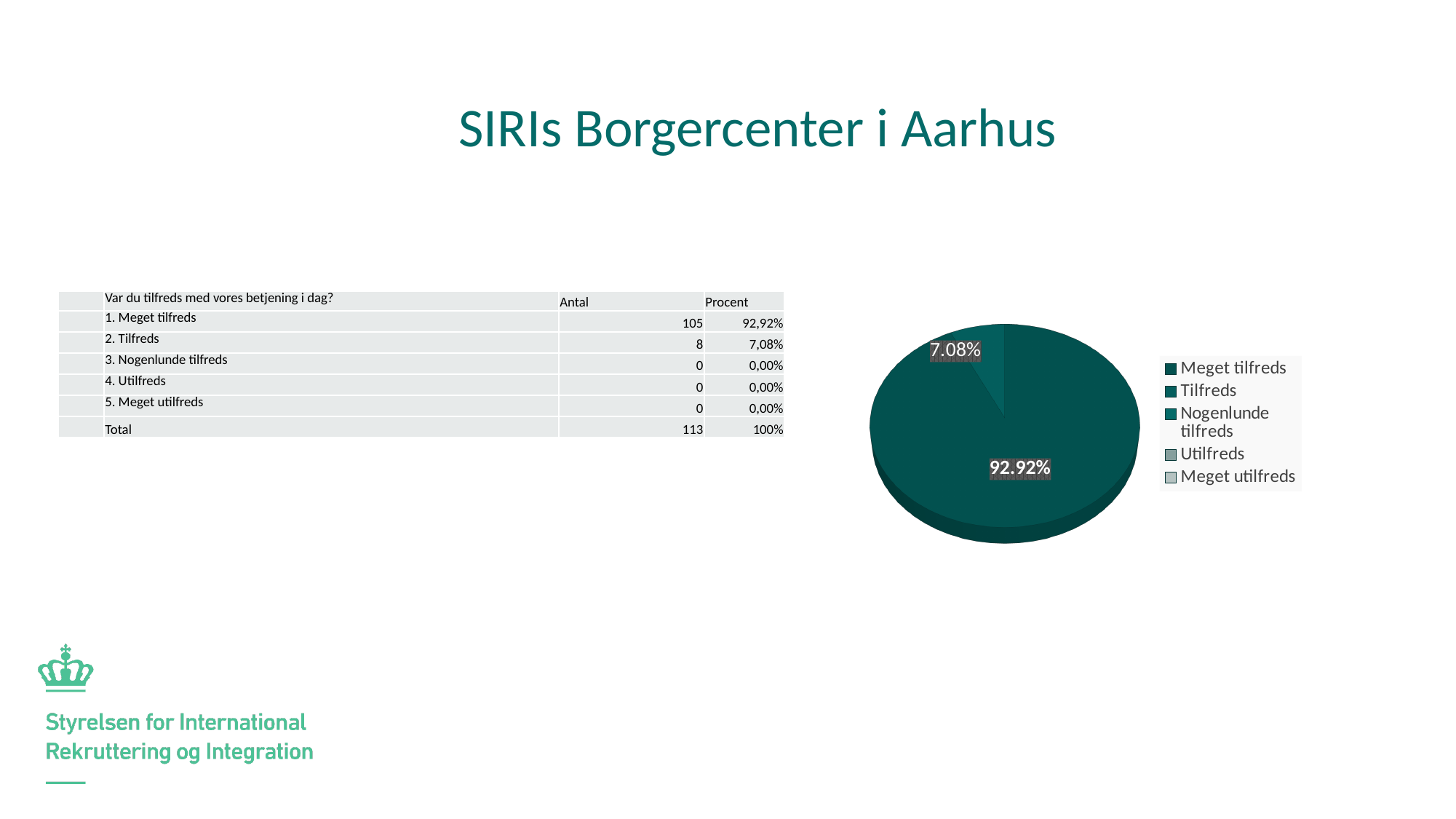
Which legend entry is listed first in the pie chart's legend? Meget tilfreds What is the difference in percentage points between the Meget tilfreds slice and the Tilfreds slice in the pie chart? 85.84% Which is larger in the pie chart, the Meget tilfreds slice or the Tilfreds slice? Meget tilfreds Which legend entry is listed last in the pie chart's legend? Meget utilfreds Is the share of the Meget tilfreds slice in the pie chart greater or less than 90%? greater How many slices of the pie chart have a data label printed on them? 2 Which category has the largest slice in the pie chart? Meget tilfreds What share of the pie chart does the Tilfreds slice represent? 7.08% How many entries does the legend of the pie chart list? 5 What kind of chart is shown on the slide? pie chart What share of the pie chart does the Meget tilfreds slice represent? 92.92%